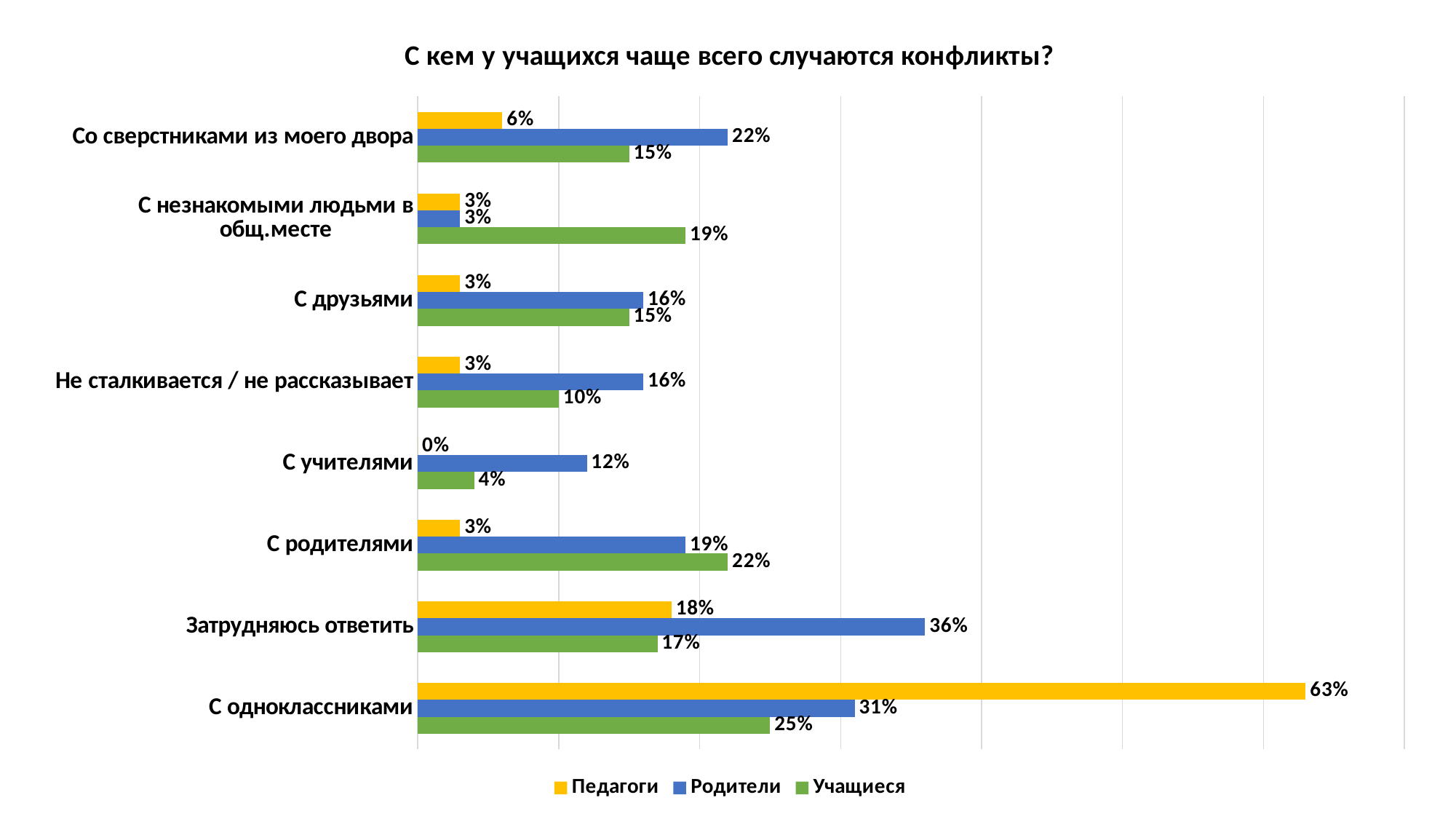
Which category has the highest value for Учащиеся? С одноклассниками What is the value for Родители in the category Затрудняюсь ответить? 36% What is the title of the chart? С кем у учащихся чаще всего случаются конфликты? What is the difference between the Педагоги and Родители values for С одноклассниками? 32% How many categories are shown on the chart? 8 What kind of chart is shown on the slide? Bar chart For С родителями, which series has the larger value: Родители or Учащиеся? Учащиеся How many series does the legend list? 3 Which colour represents the Педагоги series? Yellow What is the value for Педагоги in the category С одноклассниками? 63% What is the value for Учащиеся in the category С незнакомыми людьми в общ.месте? 19% Which category has the lowest value for Родители? С незнакомыми людьми в общ.месте